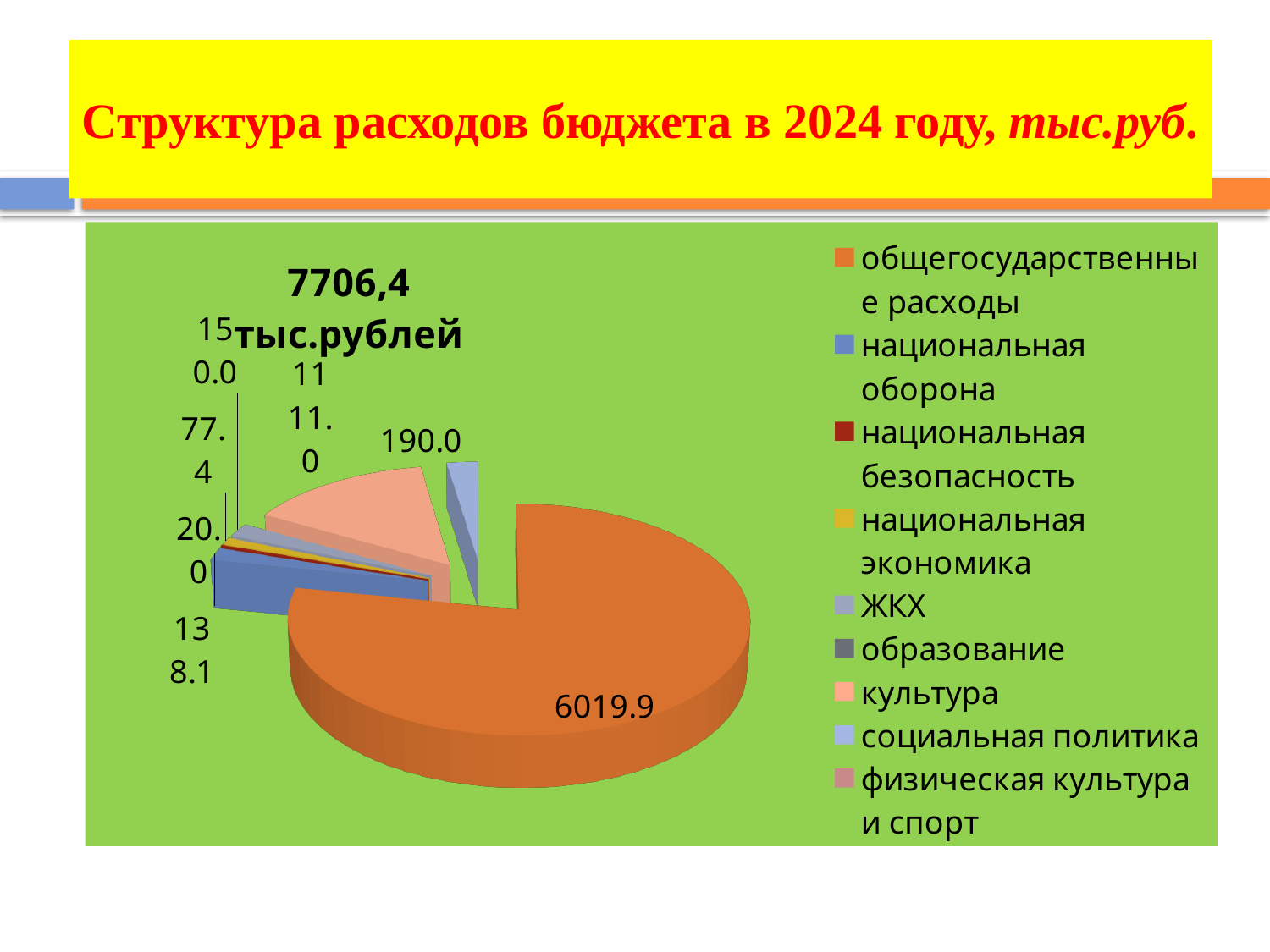
Which category has the largest slice of the pie chart? общегосударственные расходы What value is labelled on the largest slice of the pie chart? 6019.9 Which category is listed last in the legend of the pie chart? физическая культура и спорт What colour is the slice for общегосударственные расходы? orange What is the title shown above the pie chart? 7706,4 тыс.рублей Which is larger: the slice for общегосударственные расходы or the slice for культура? общегосударственные расходы Is the value for общегосударственные расходы greater or less than 5000? greater How many categories does the legend of the pie chart list? 9 What kind of chart is shown on the slide? pie chart